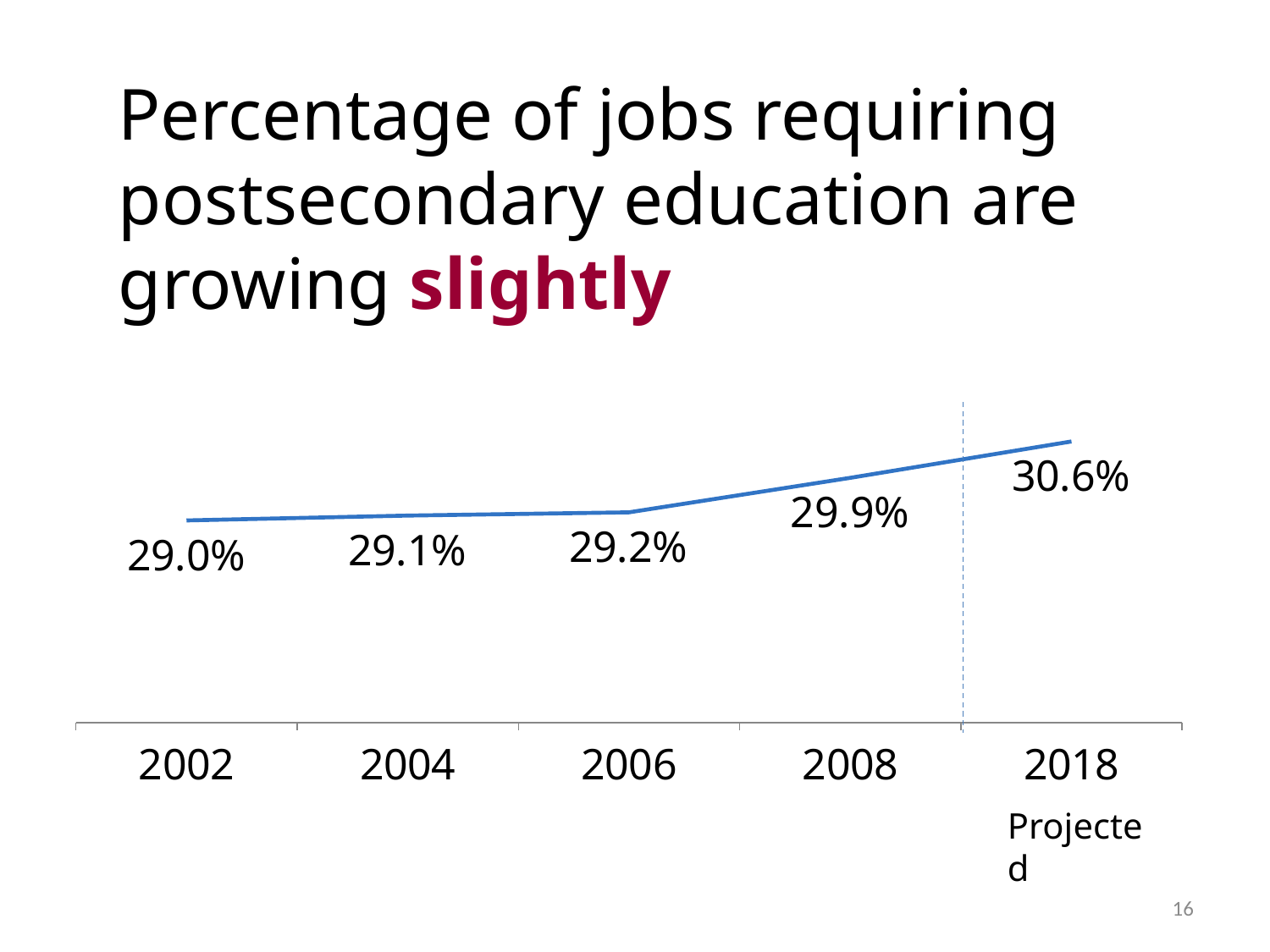
What is the value for 2008? 29.9% Which is larger, the value for 2004 or the value for 2008? 2008 Which year has the lowest value? 2002 What is the value for 2006? 29.2% What is the projected value for 2018? 30.6% What kind of chart is shown? line chart How many data points are plotted on the chart? 5 What is the difference between the 2008 value and the 2006 value? 0.7% What is the value for 2002? 29.0% Do the values rise or fall from 2002 to 2018? rise What is the difference between the 2018 value and the 2002 value? 1.6% Which year has the highest value? 2018